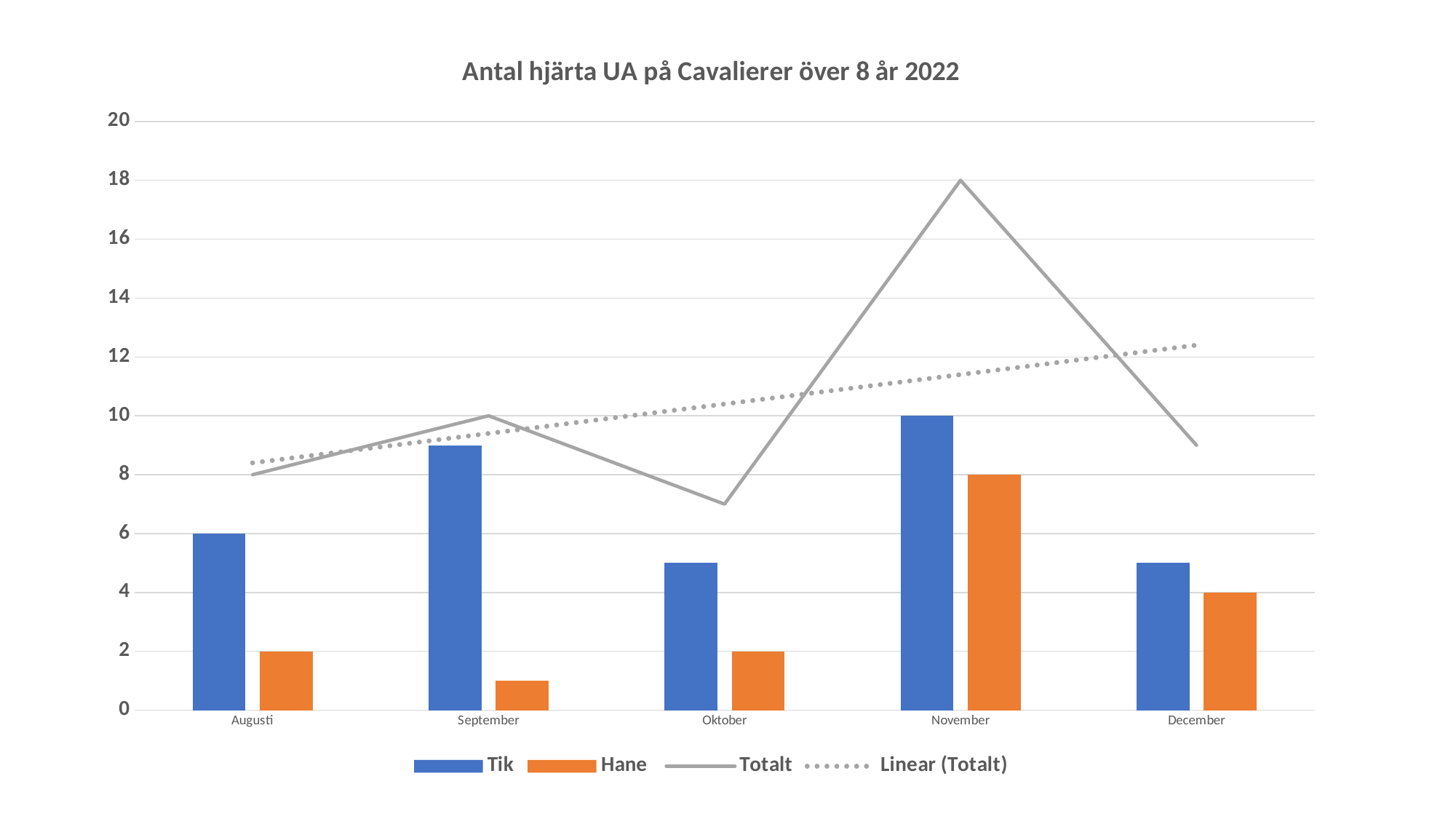
What is the Totalt value in November? 18 What is the difference between Tik and Hane in November? 2 How many months are shown on the x axis? 5 In which month is the Totalt line highest? November Is the value for Tik in September greater or less than 8? greater What is the value for Tik in November? 10 What is the title of the chart? Antal hjärta UA på Cavalierer över 8 år 2022 In which month is the Hane value lowest? September What kind of chart is shown on the slide? A bar chart combined with line series What is the value for Hane in November? 8 How many series does the legend list? 4 In Augusti, which is larger, Tik or Hane? Tik